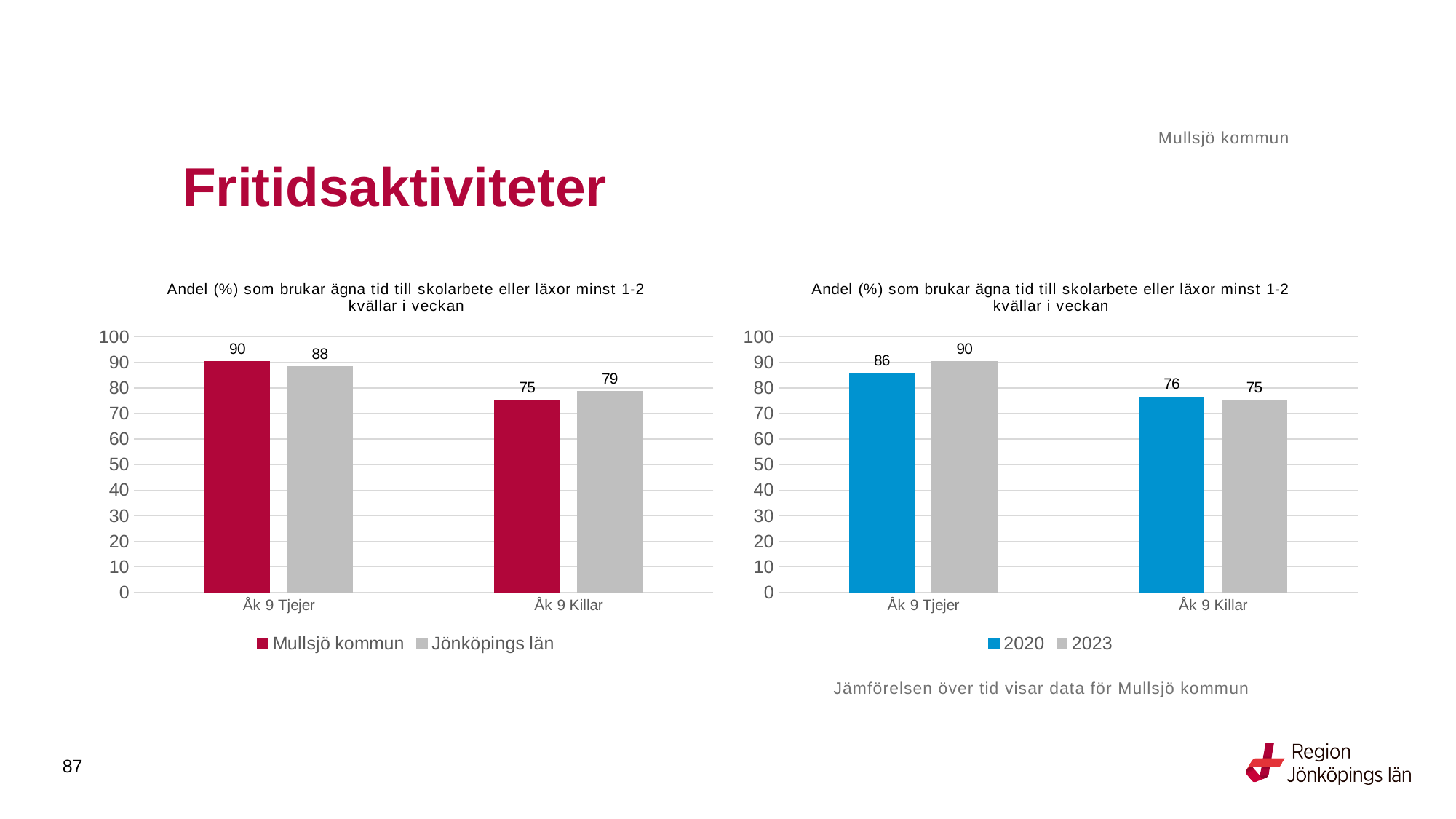
In the right chart, how many categories are shown on the x axis? 2 In the right chart, what is the value for 2020 for Åk 9 Tjejer? 86 In the left chart, which is larger for Åk 9 Tjejer: Mullsjö kommun or Jönköpings län? Mullsjö kommun In the left chart, how many series does the legend list? 2 In the right chart, what is the value for 2023 for Åk 9 Killar? 75 In the right chart, which series is shown in blue? 2020 In the right chart, which category has the highest value for 2023? Åk 9 Tjejer In the left chart, what is the value for Jönköpings län for Åk 9 Killar? 79 In the right chart, what is the difference between 2023 and 2020 for Åk 9 Tjejer? 4 What kind of chart is the right chart? Bar chart In the left chart, what is the value for Mullsjö kommun for Åk 9 Tjejer? 90 In the left chart, what is the difference between Mullsjö kommun and Jönköpings län for Åk 9 Killar? 4